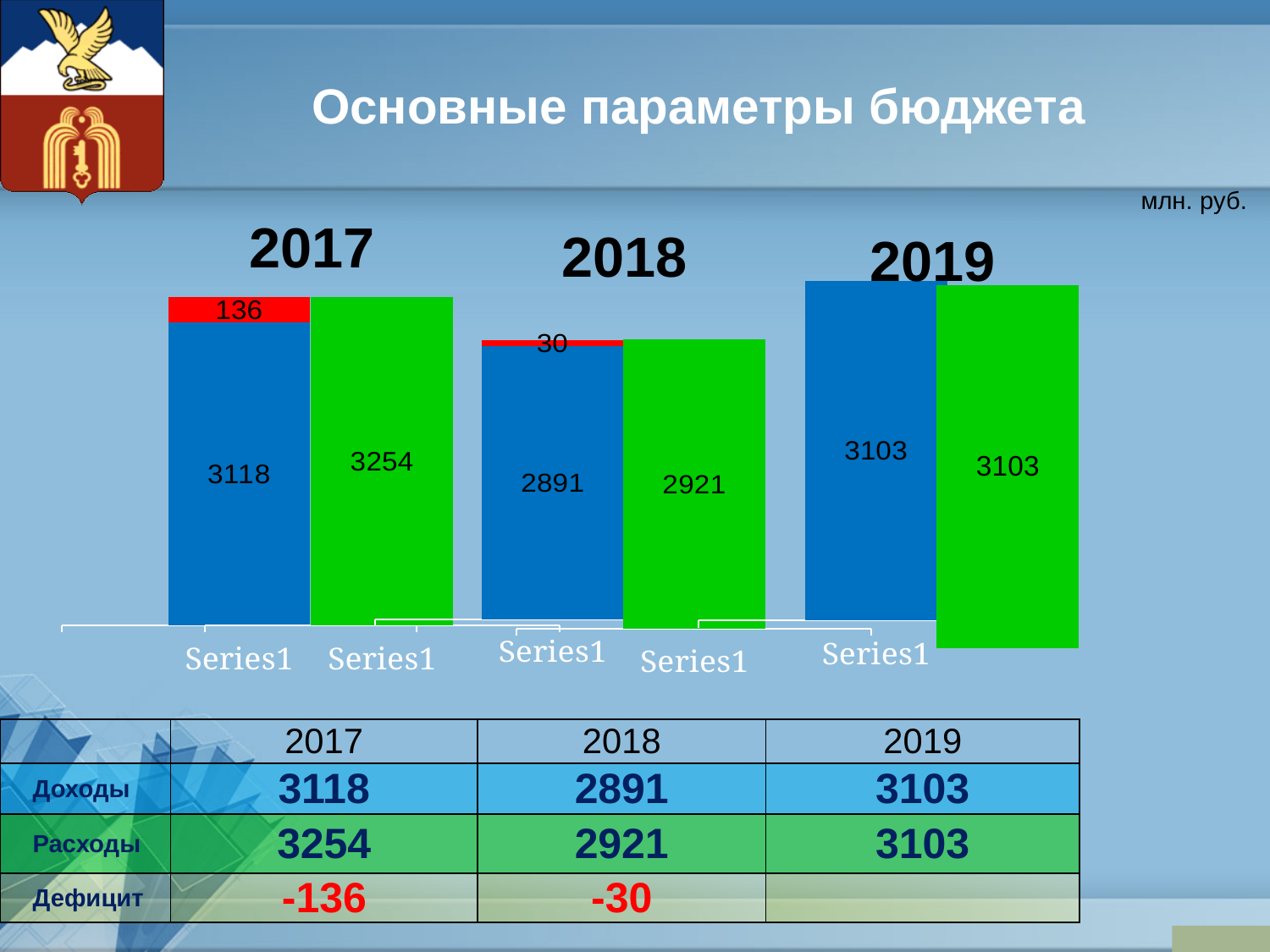
What is the value of the blue bar (Доходы) for 2017? 3118 Which year has the lowest blue bar (Доходы)? 2018 What is the title of the slide containing the chart? Основные параметры бюджета What kind of chart is shown on the slide? bar chart How many years are shown on the chart? 3 What value is shown on the red segment above the blue bar for 2018? 30 What is the value of the green bar (Расходы) for 2018? 2921 Which year has the highest green bar (Расходы)? 2017 What value is shown on the red segment above the blue bar for 2017? 136 What is the difference between the green bar and the blue bar for 2017? 136 What is the value of the green bar (Расходы) for 2019? 3103 Which is larger for 2018, the blue bar (Доходы) or the green bar (Расходы)? the green bar (Расходы)